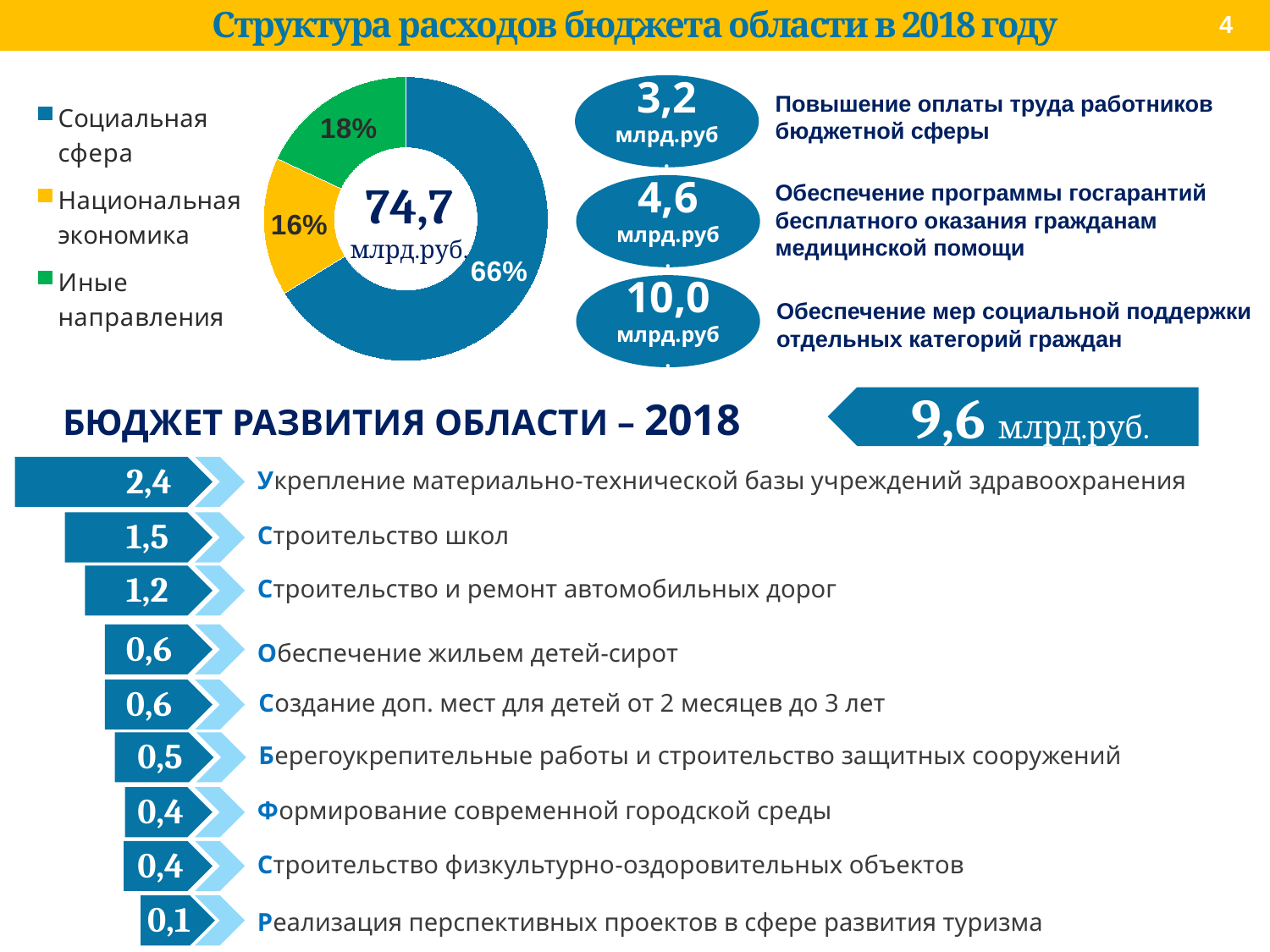
How many categories does the pie chart show? 3 Which category has the smallest slice in the pie chart? Национальная экономика In the pie chart, by how many percentage points does Социальная сфера exceed Иные направления? 48 percentage points What colour is the Социальная сфера slice in the pie chart? blue What kind of chart is shown in the upper part of the slide? pie chart In the pie chart, what share is shown for Социальная сфера? 66% In the pie chart, what share is shown for Национальная экономика? 16% In the pie chart, which slice is larger: Иные направления or Национальная экономика? Иные направления Which category has the largest slice in the pie chart? Социальная сфера What total value is printed in the centre of the pie chart? 74,7 млрд.руб. In the pie chart, what share is shown for Иные направления? 18% In the pie chart, by how many percentage points does Иные направления exceed Национальная экономика? 2 percentage points